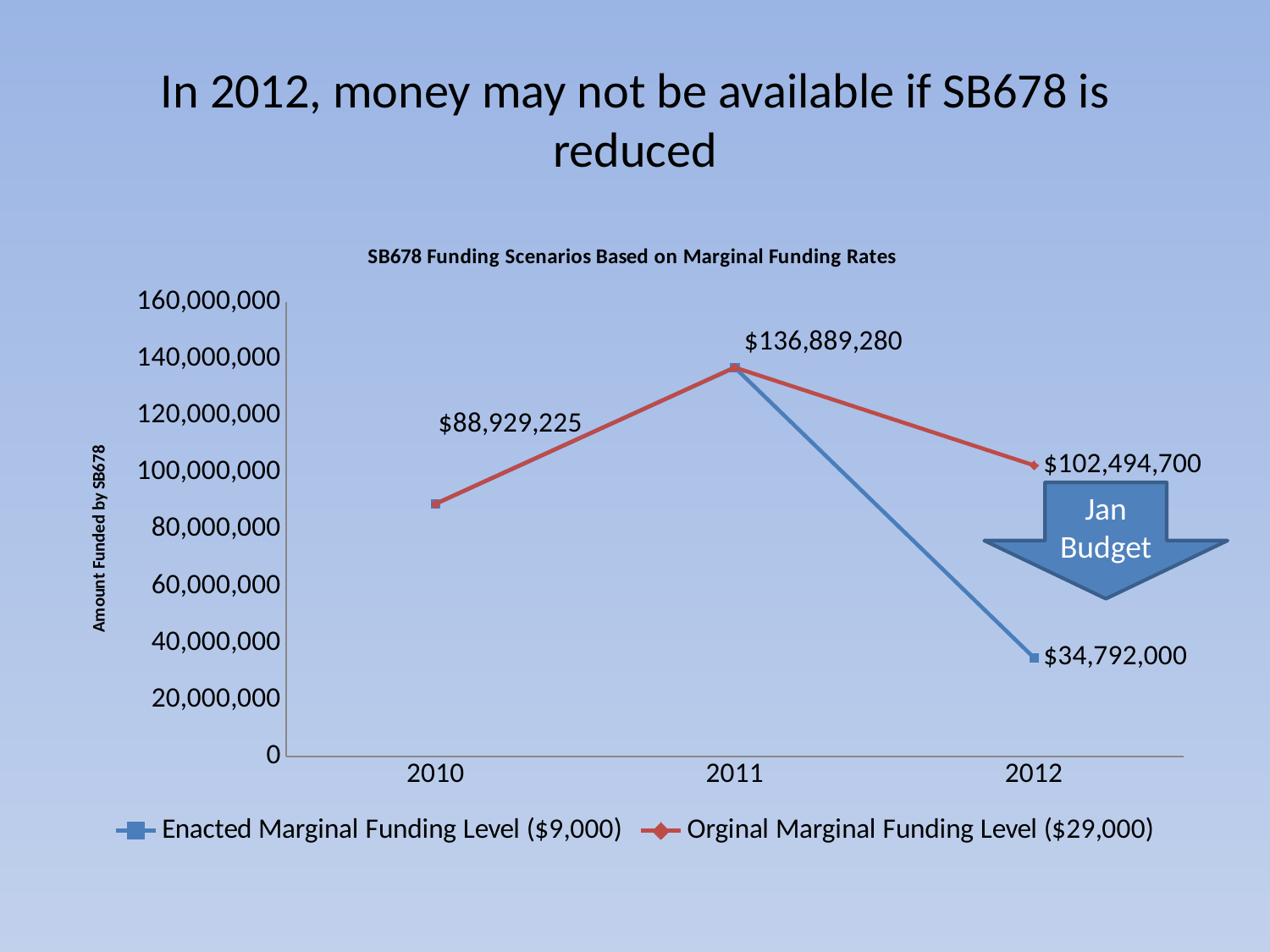
What is the value for the Orginal Marginal Funding Level ($29,000) series in 2012? $102,494,700 What is the value plotted for 2011? $136,889,280 Which series has the larger value in 2012, Enacted Marginal Funding Level ($9,000) or Orginal Marginal Funding Level ($29,000)? Orginal Marginal Funding Level ($29,000) Which year has the highest plotted value? 2011 What is the value plotted for 2010? $88,929,225 What is the value for the Enacted Marginal Funding Level ($9,000) series in 2012? $34,792,000 How many years are plotted on the x axis? 3 What is the difference between the Orginal Marginal Funding Level ($29,000) and the Enacted Marginal Funding Level ($9,000) values in 2012? $67,702,700 What is the title of the chart? SB678 Funding Scenarios Based on Marginal Funding Rates Does the Enacted Marginal Funding Level ($9,000) series rise or fall from 2011 to 2012? Fall How many series does the legend list? 2 What kind of chart is shown on the slide? Line chart